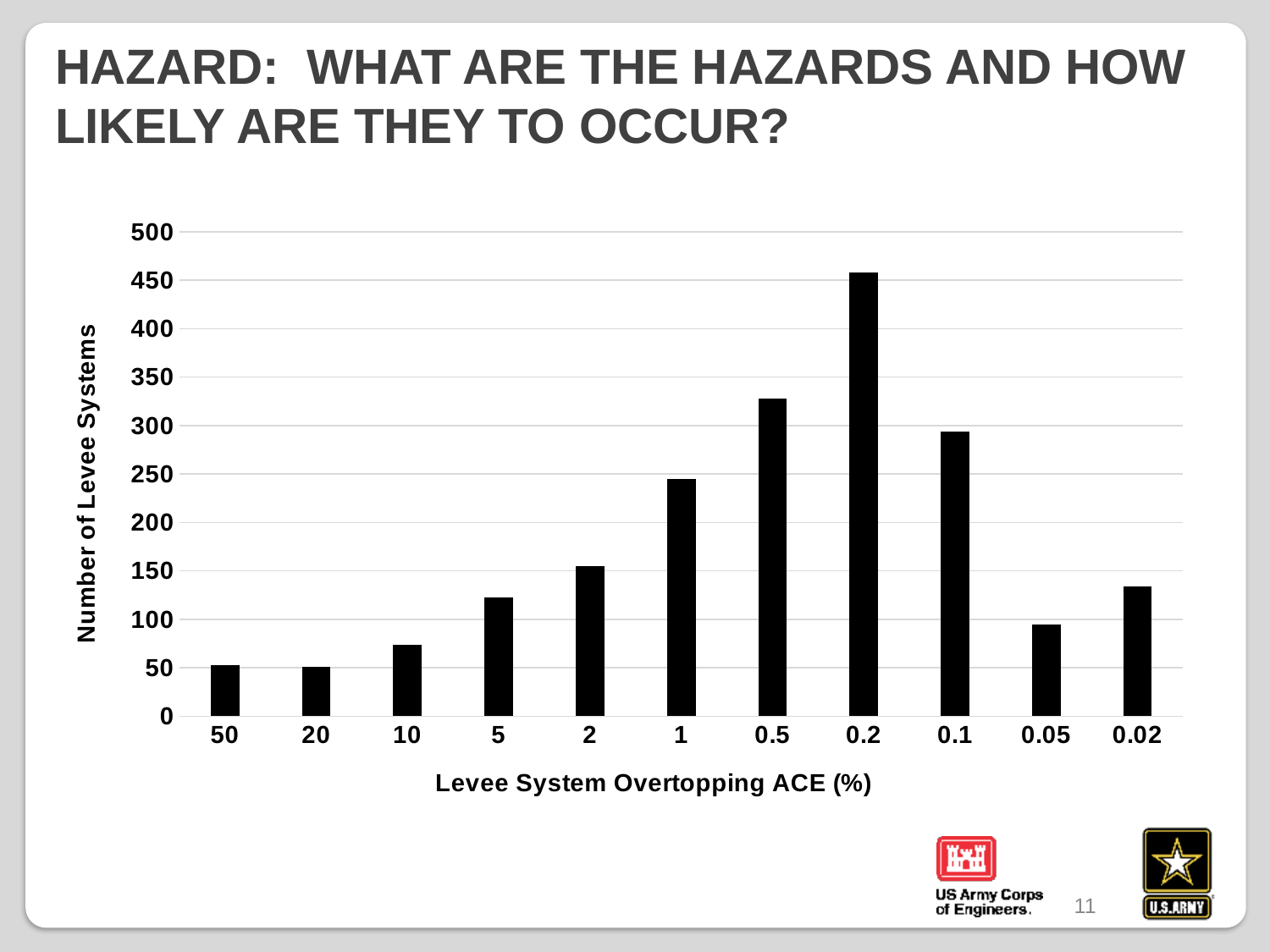
What is the title of the y axis? Number of Levee Systems Which Levee System Overtopping ACE (%) category has the highest number of levee systems? 0.2 Is the number of levee systems for the 0.2 category greater or less than 400? greater What kind of chart is shown on the slide? bar chart Is the number of levee systems for the 0.5 category greater or less than 300? greater Which has more levee systems, the 0.5 category or the 0.1 category? 0.5 Is the number of levee systems for the 0.02 category greater or less than 100? greater Which has more levee systems, the 0.02 category or the 0.05 category? 0.02 How many Levee System Overtopping ACE (%) categories are shown on the x axis? 11